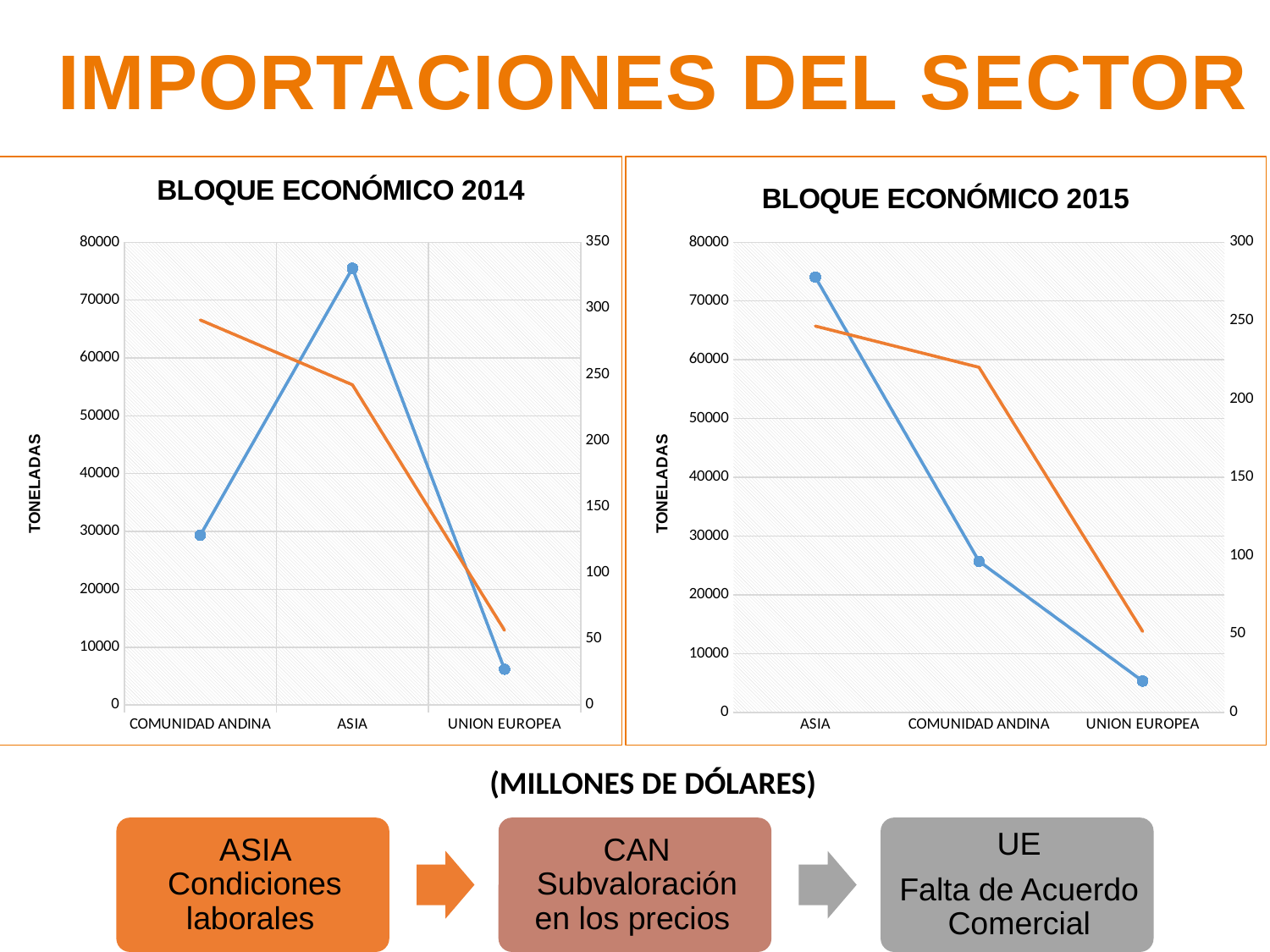
In the 'BLOQUE ECONÓMICO 2014' chart, is the blue line value for UNION EUROPEA greater or less than 10000? less In the 'BLOQUE ECONÓMICO 2015' chart, do the values on the blue line rise or fall from ASIA to UNION EUROPEA? fall In the 'BLOQUE ECONÓMICO 2015' chart, is the orange line value for UNION EUROPEA (right axis) greater or less than 100? less What is the label on the left vertical axis of the 'BLOQUE ECONÓMICO 2014' chart? TONELADAS In the 'BLOQUE ECONÓMICO 2015' chart, is the blue line value for COMUNIDAD ANDINA greater or less than 20000? greater In the 'BLOQUE ECONÓMICO 2015' chart, which category has the lowest value on the orange line? UNION EUROPEA In the 'BLOQUE ECONÓMICO 2014' chart, which category has the lowest value on the blue line? UNION EUROPEA What type of chart is the 'BLOQUE ECONÓMICO 2014' chart? line chart In the 'BLOQUE ECONÓMICO 2015' chart, which category has the highest value on the blue line? ASIA How many categories are shown on the x axis of the 'BLOQUE ECONÓMICO 2015' chart? 3 In the 'BLOQUE ECONÓMICO 2014' chart, which category has the highest value on the blue line? ASIA